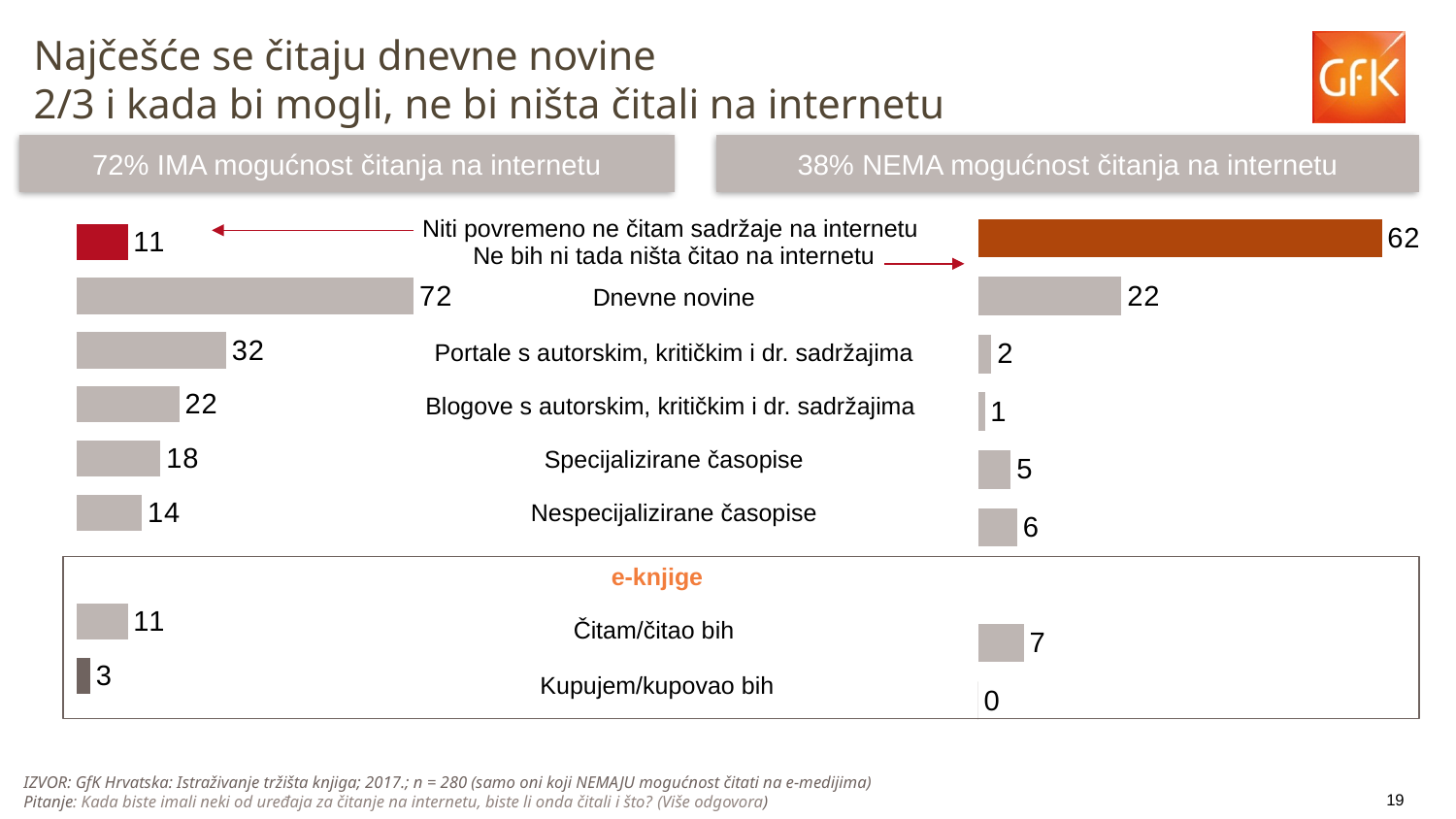
In the right chart (38% NEMA mogućnost čitanja na internetu), what is the value for Ne bih ni tada ništa čitao na internetu? 62 In the left chart (72% IMA mogućnost čitanja na internetu), what is the difference between Dnevne novine and Portale s autorskim, kritičkim i dr. sadržajima? 40 How many categories are shown in the left chart (72% IMA mogućnost čitanja na internetu)? 8 What type of chart is used on this slide? Bar chart In the right chart (38% NEMA mogućnost čitanja na internetu), which category has the lowest value? Kupujem/kupovao bih In the left chart (72% IMA mogućnost čitanja na internetu), which category has the highest value? Dnevne novine In the left chart (72% IMA mogućnost čitanja na internetu), what is the value for Portale s autorskim, kritičkim i dr. sadržajima? 32 Which is larger: the value for Čitam/čitao bih in the left chart or in the right chart? Left chart (11) In the left chart (72% IMA mogućnost čitanja na internetu), which category has the lowest value? Kupujem/kupovao bih In the left chart (72% IMA mogućnost čitanja na internetu), what is the value for Dnevne novine? 72 In the right chart (38% NEMA mogućnost čitanja na internetu), what is the value for Dnevne novine? 22 In the right chart (38% NEMA mogućnost čitanja na internetu), what is the difference between Specijalizirane časopise and Nespecijalizirane časopise? 1